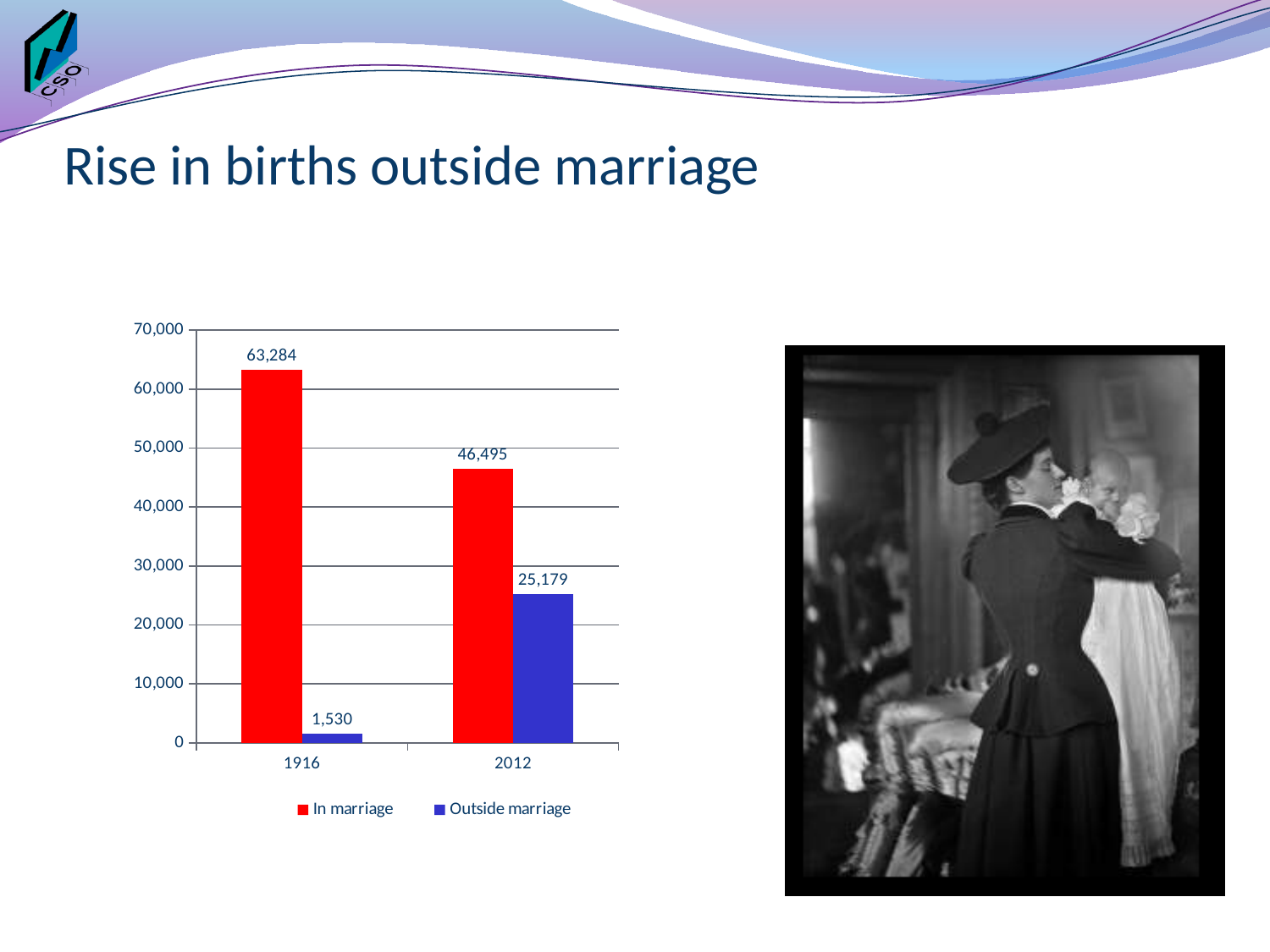
How many series does the legend list? 2 Which year has the lowest value for Outside marriage? 1916 What is the value for In marriage in 2012? 46,495 What is the difference between the Outside marriage values for 2012 and 1916? 23,649 What is the difference between the In marriage values for 1916 and 2012? 16,789 What is the value for Outside marriage in 2012? 25,179 Does the Outside marriage value rise or fall from 1916 to 2012? Rise Which year has the highest value for In marriage? 1916 Which is larger in 2012, In marriage or Outside marriage? In marriage What is the value for Outside marriage in 1916? 1,530 What is the value for In marriage in 1916? 63,284 What kind of chart is shown on the slide? Bar chart